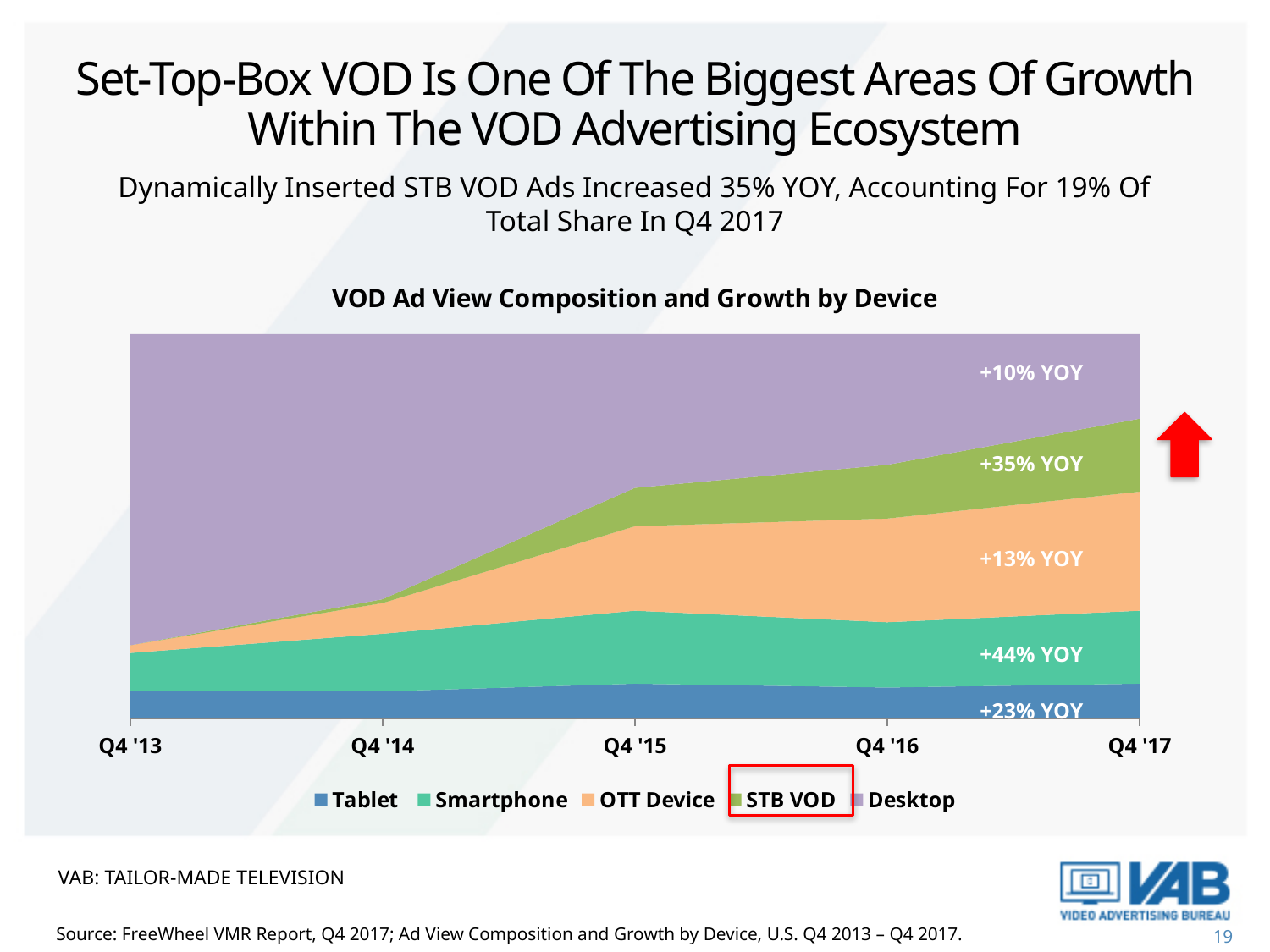
What YOY growth is labeled for Tablet on the chart? +23% YOY What YOY growth is labeled for STB VOD on the chart? +35% YOY Which device has the lowest labeled YOY growth on the chart? Desktop Does the STB VOD share of VOD ad views rise or fall from Q4 '13 to Q4 '17? Rise What is the title of the chart? VOD Ad View Composition and Growth by Device What YOY growth is labeled for OTT Device on the chart? +13% YOY Which device has the highest labeled YOY growth on the chart? Smartphone How many time periods are shown on the x axis of the chart? 5 What YOY growth is labeled for Desktop on the chart? +10% YOY What kind of chart is shown on the slide? Stacked area chart How many series does the chart legend list? 5 What YOY growth is labeled for Smartphone on the chart? +44% YOY